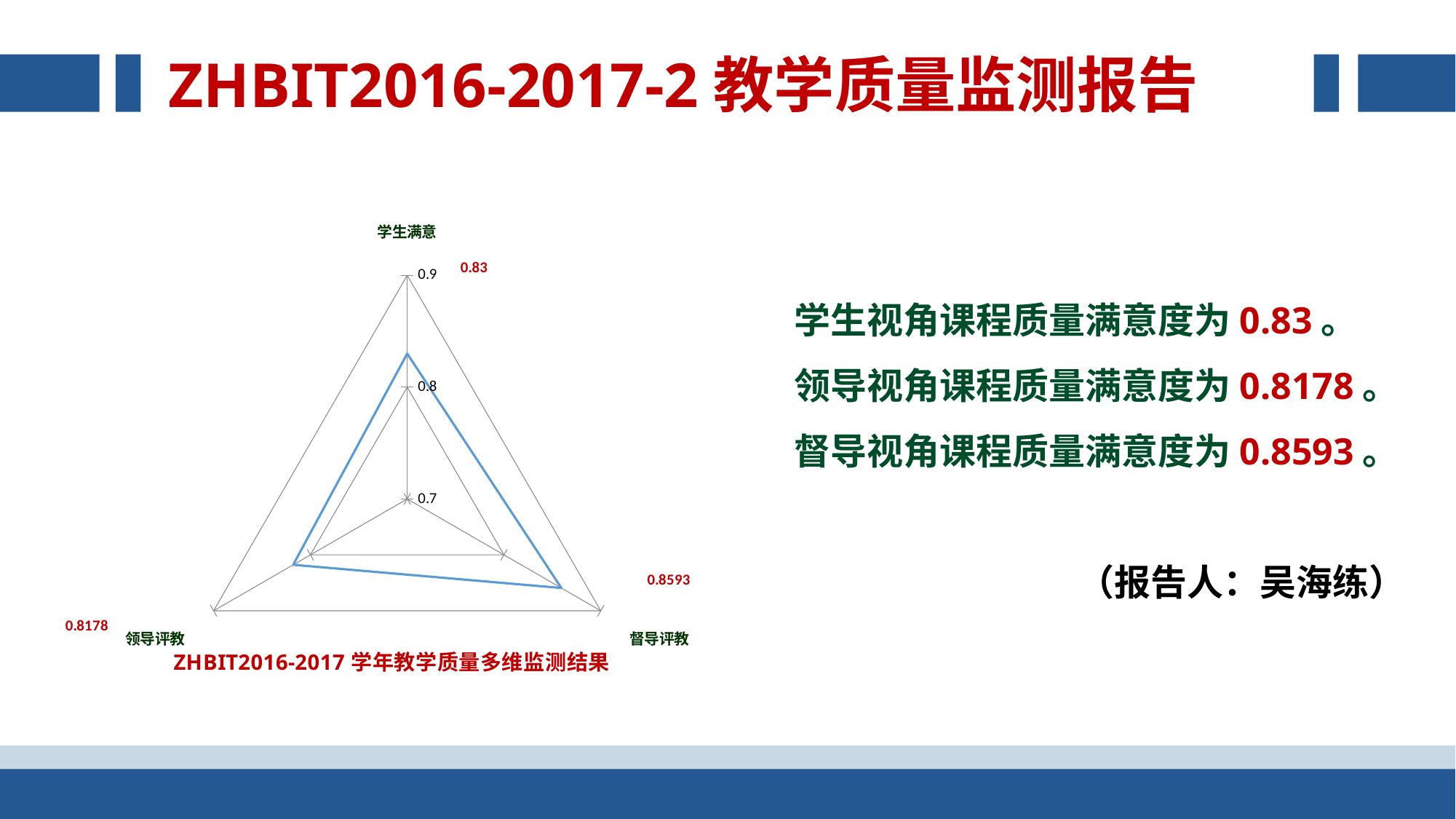
Is the value for 督导评教 greater or less than 0.8? greater What is the value for 领导评教 on the radar chart? 0.8178 What kind of chart is shown on the slide? Radar chart Which category has the highest value on the radar chart? 督导评教 What is the difference between the values for 督导评教 and 领导评教? 0.0415 How many categories (axes) does the radar chart have? 3 Which is larger, the value for 学生满意 or the value for 领导评教? 学生满意 What is the title of the chart? ZHBIT2016-2017 学年教学质量多维监测结果 What is the value for 学生满意 on the radar chart? 0.83 Which category has the lowest value on the radar chart? 领导评教 What is the value for 督导评教 on the radar chart? 0.8593 What is the difference between the values for 督导评教 and 学生满意? 0.0293